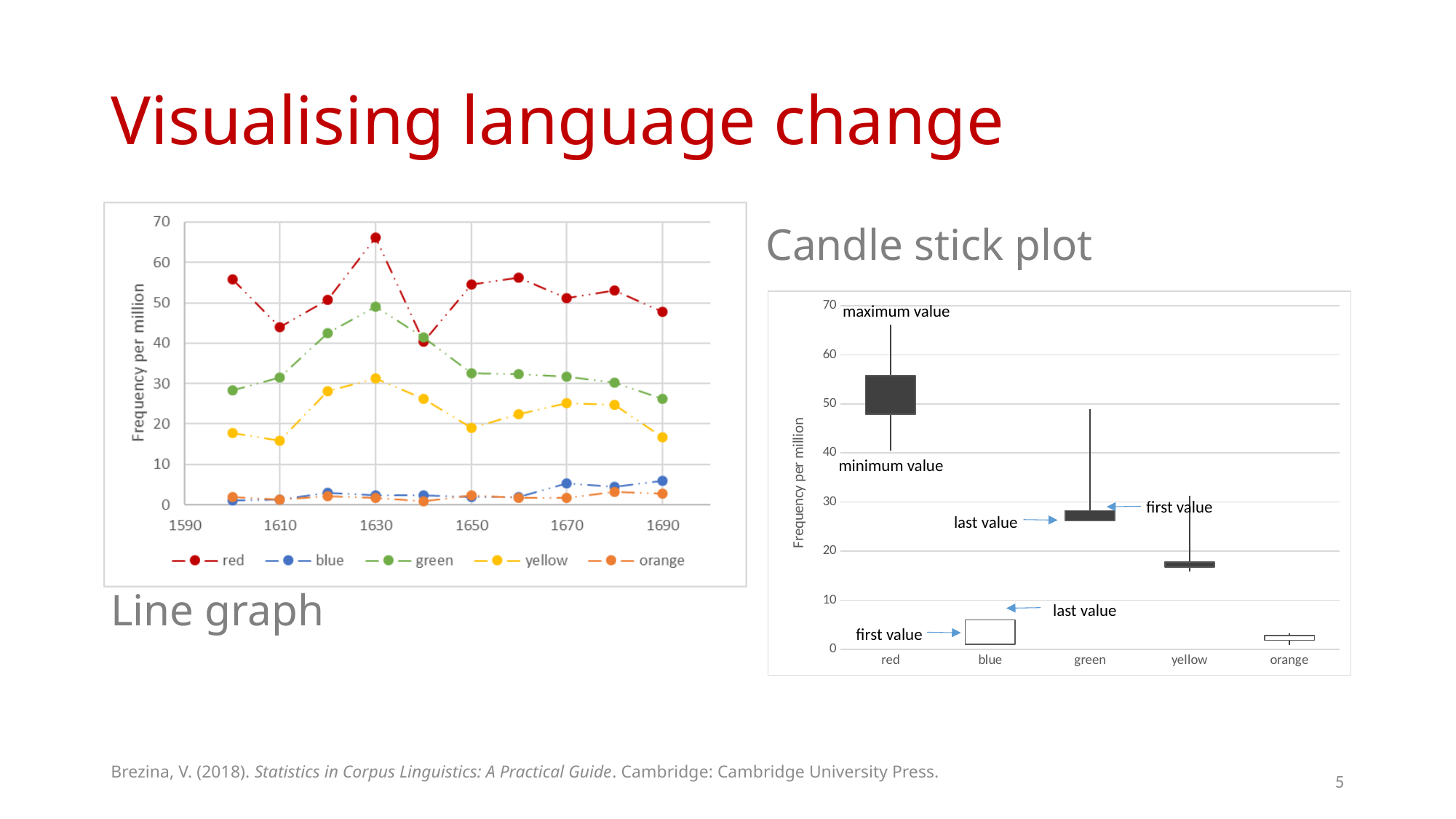
On the candle stick plot, how many categories are shown on the x axis? 5 On the candle stick plot, which category has the highest maximum value? red On the line graph, how many series does the legend list? 5 On the line graph, is the value for green at 1600 greater or less than 30? less On the line graph, is the value for red at 1630 greater or less than 60? greater On the line graph, what kind of chart is shown? line chart On the line graph, is the value for yellow at 1610 greater or less than 20? less On the line graph, which is larger at 1630, the value for red or the value for green? red On the line graph, which series has the highest value at 1630? red On the line graph, how many data points does each series have? 10 On the line graph, does the yellow series rise or fall from 1600 to 1630? rise On the line graph, what is the label of the y axis? Frequency per million